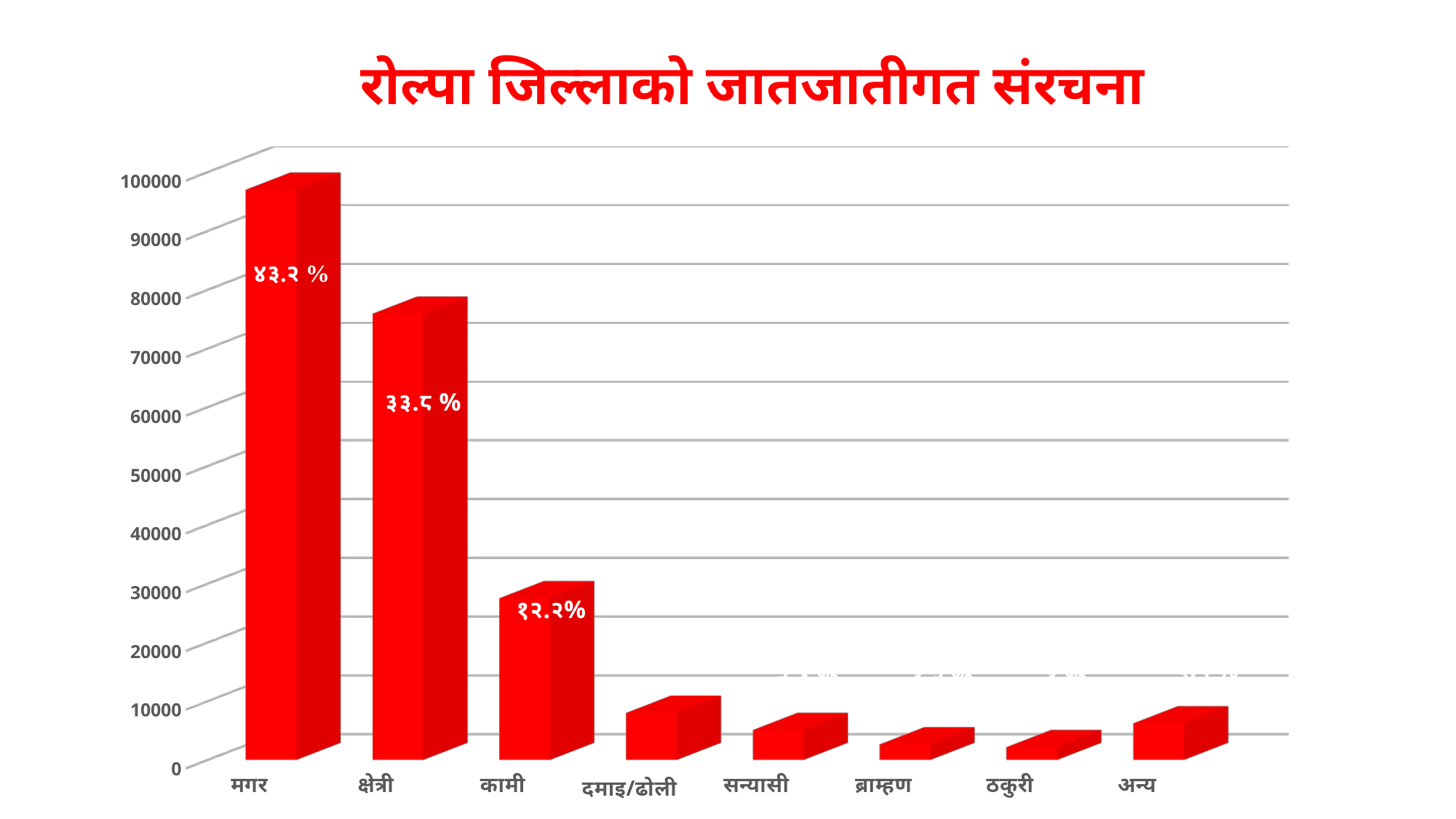
What percentage label is shown on the bar for क्षेत्री? ३३.८ % What type of chart is shown on the slide? bar chart How many categories are shown on the x axis? 8 Which category has the highest bar? मगर Is the value for मगर greater or less than 90000? greater Which is larger, the value for कामी or the value for दमाइ/ढोली? कामी What is the title of the chart? रोल्पा जिल्लाको जातजातीगत संरचना What percentage label is shown on the bar for कामी? १२.२% Is the value for क्षेत्री greater or less than 70000? greater Is the value for कामी greater or less than 30000? less What percentage label is shown on the bar for मगर? ४३.२ % What is the difference between the percentage labels for मगर and क्षेत्री? ९.४ %